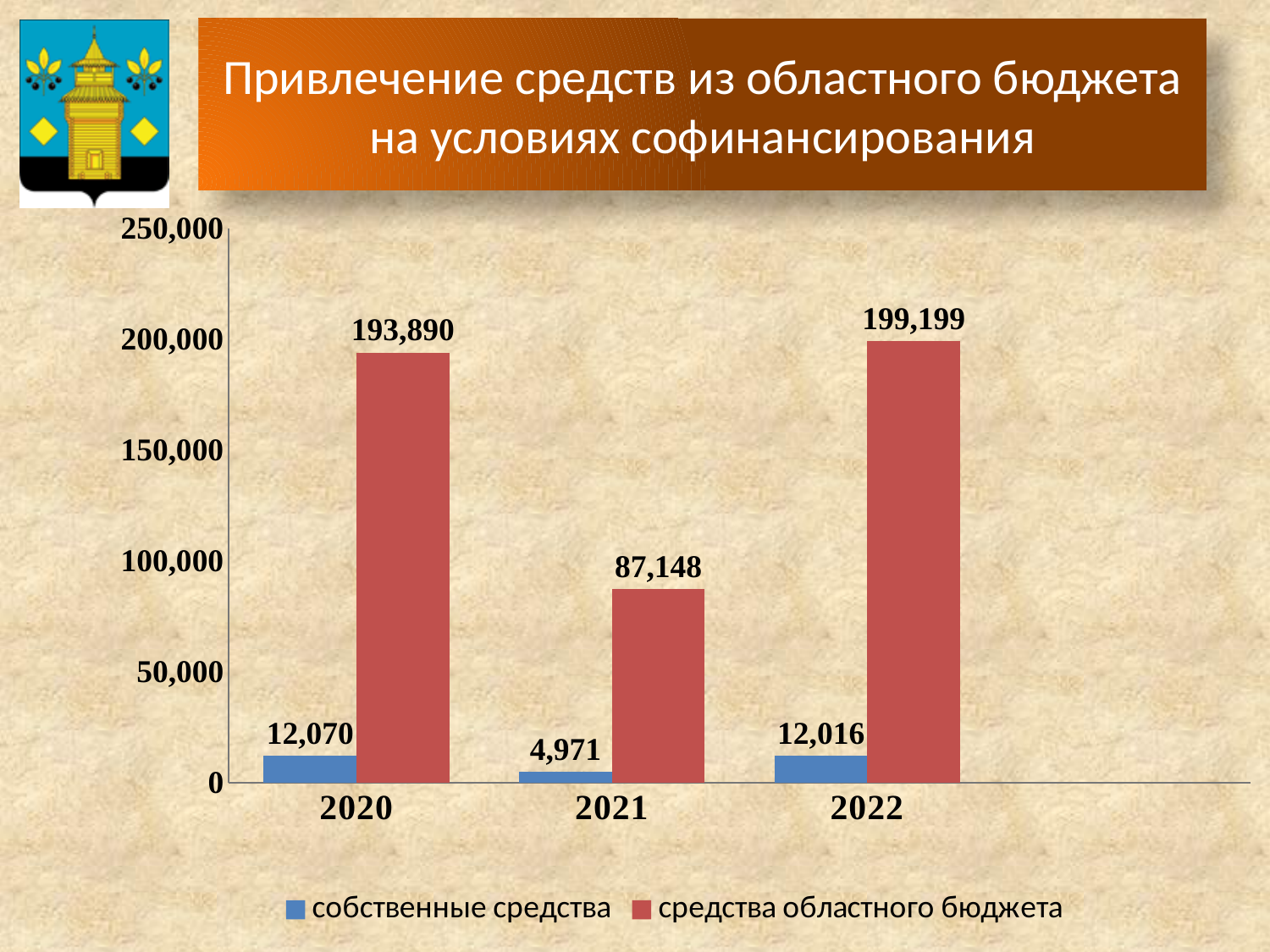
What kind of chart is shown on the slide? bar chart What is the difference between средства областного бюджета in 2022 and in 2021? 112,051 Is the value of средства областного бюджета for 2021 greater or less than 100,000? less In which year is собственные средства the lowest? 2021 What is the value of средства областного бюджета for 2022? 199,199 How many years are shown on the x axis? 3 In which year is средства областного бюджета the highest? 2022 What is the value of собственные средства for 2021? 4,971 Which colour represents средства областного бюджета in the chart? red What is the value of средства областного бюджета for 2020? 193,890 Which is larger: собственные средства in 2020 or in 2022? 2020 How many series does the legend list? 2